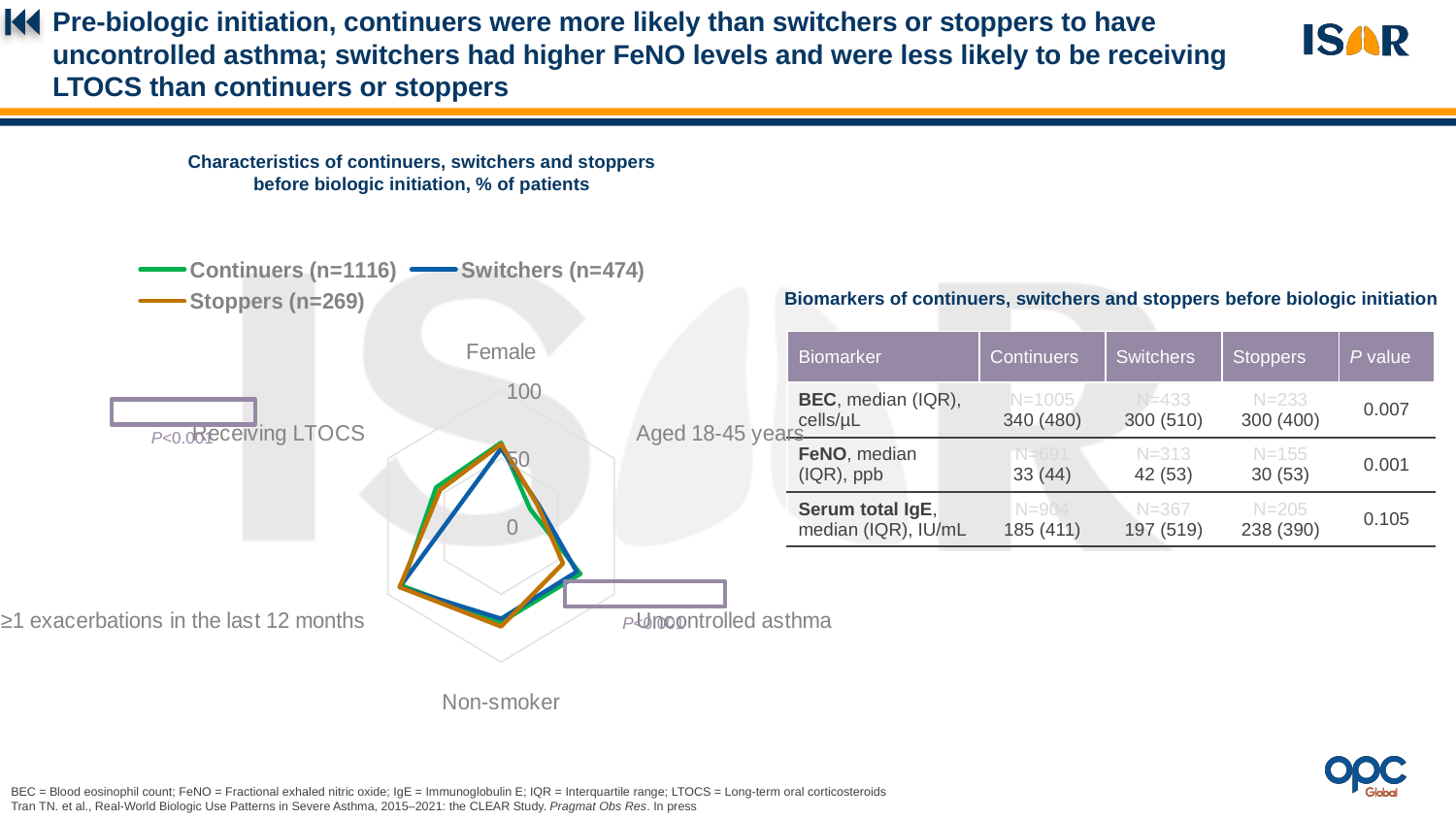
In the radar chart, which is larger for Receiving LTOCS: Continuers or Switchers? Continuers In the radar chart, is the value for Non-smoker for Continuers greater or less than 50? greater In the radar chart, which series has the lowest value for Receiving LTOCS? Switchers (n=474) How many series does the legend of the radar chart list? 3 In the radar chart, is the value for ≥1 exacerbations in the last 12 months for Stoppers greater or less than 50? greater What is the maximum value shown on the radar chart's axis scale? 100 In the radar chart, which is larger for Uncontrolled asthma: Continuers or Switchers? Continuers In the radar chart, is the value for Aged 18-45 years for Switchers greater or less than 50? less What is the title of the radar chart? Characteristics of continuers, switchers and stoppers before biologic initiation, % of patients In the radar chart, what is the sample size shown in the legend for Switchers? n=474 What kind of chart is shown on the left of the slide? Radar chart How many categories (axes) does the radar chart have? 6